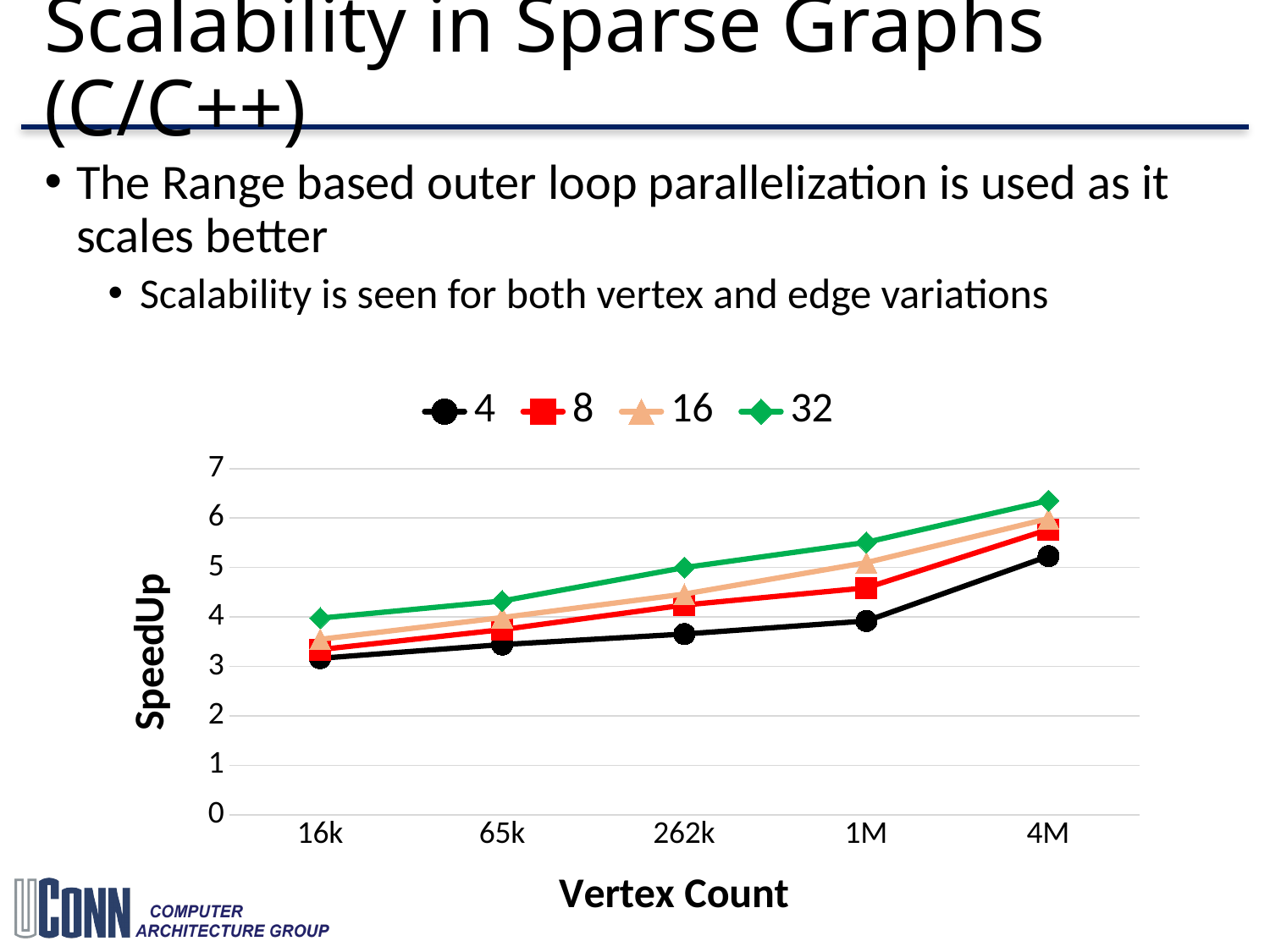
What is the label of the y axis? SpeedUp How many vertex count categories are plotted on the x axis? 5 Is the speedup for the 8 series at 1M vertices greater or less than 5? less Is the speedup for the 16 series at 16k vertices greater or less than 4? less Does the speedup for the 32 series rise or fall as the vertex count increases from 16k to 4M? rise What is the label of the x axis? Vertex Count Is the speedup for the 32 series at 4M vertices greater or less than 6? greater At 4M vertices, which series has the larger speedup, 4 or 32? 32 How many series does the legend list? 4 What kind of chart is shown on the slide? line chart Which series has the lowest speedup at 16k vertices? 4 Which series has the highest speedup at 1M vertices? 32